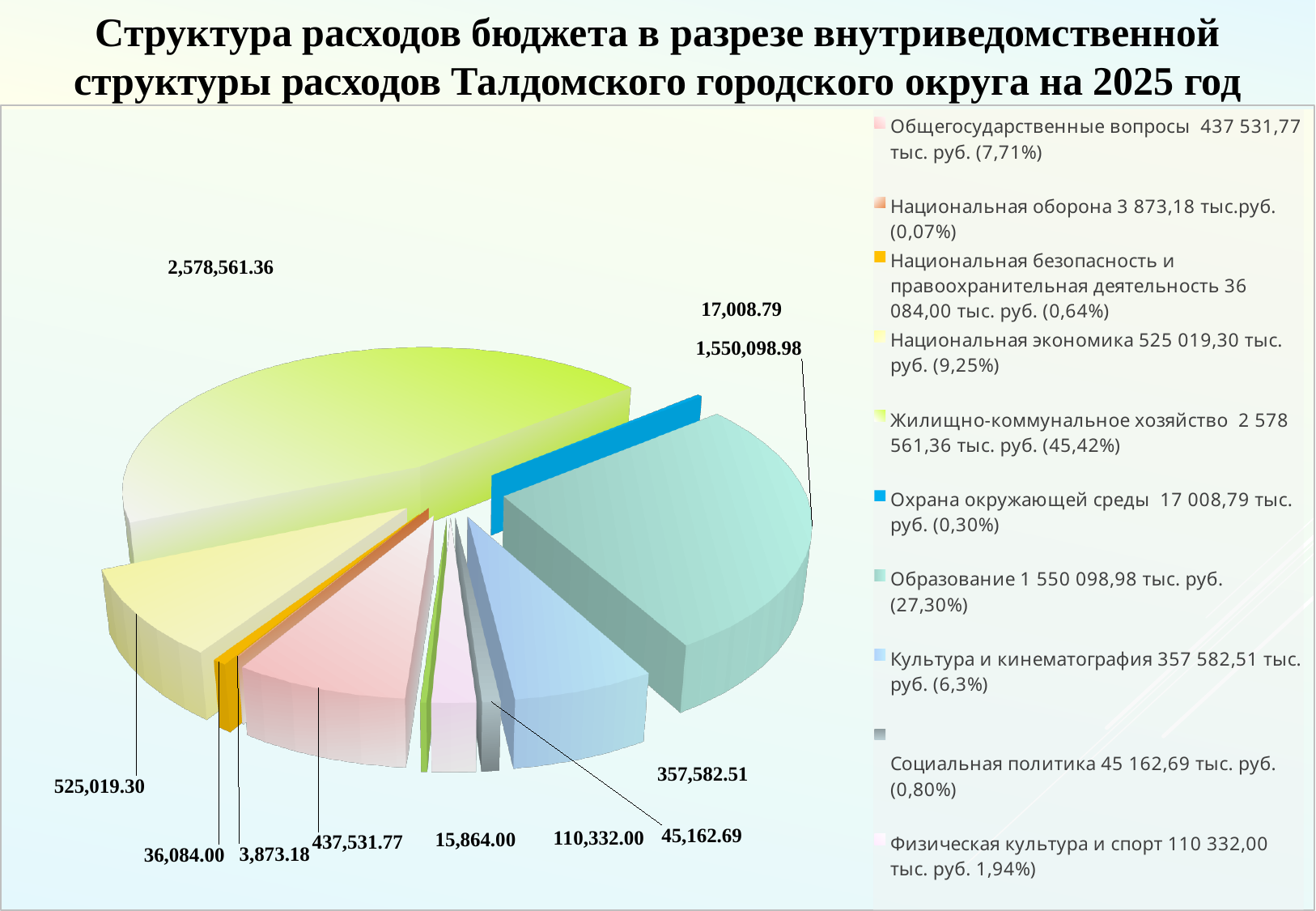
What share of the pie does Образование account for, according to the legend? 27,30% What colour is the legend marker for Охрана окружающей среды? Blue What share of the pie does Жилищно-коммунальное хозяйство account for, according to the legend? 45,42% Which category has the smallest slice in the pie chart? Национальная оборона What is the value shown for Культура и кинематография? 357,582.51 What is the value shown for Национальная безопасность и правоохранительная деятельность? 36,084.00 How many data labels are shown on the pie chart? 11 Which category has the largest slice in the pie chart? Жилищно-коммунальное хозяйство Which is larger: the value for Национальная экономика or the value for Общегосударственные вопросы? Национальная экономика What is the value shown for Образование? 1,550,098.98 What type of chart is shown on the slide? Pie chart What is the difference between the values for Образование and Культура и кинематография? 1,192,516.47